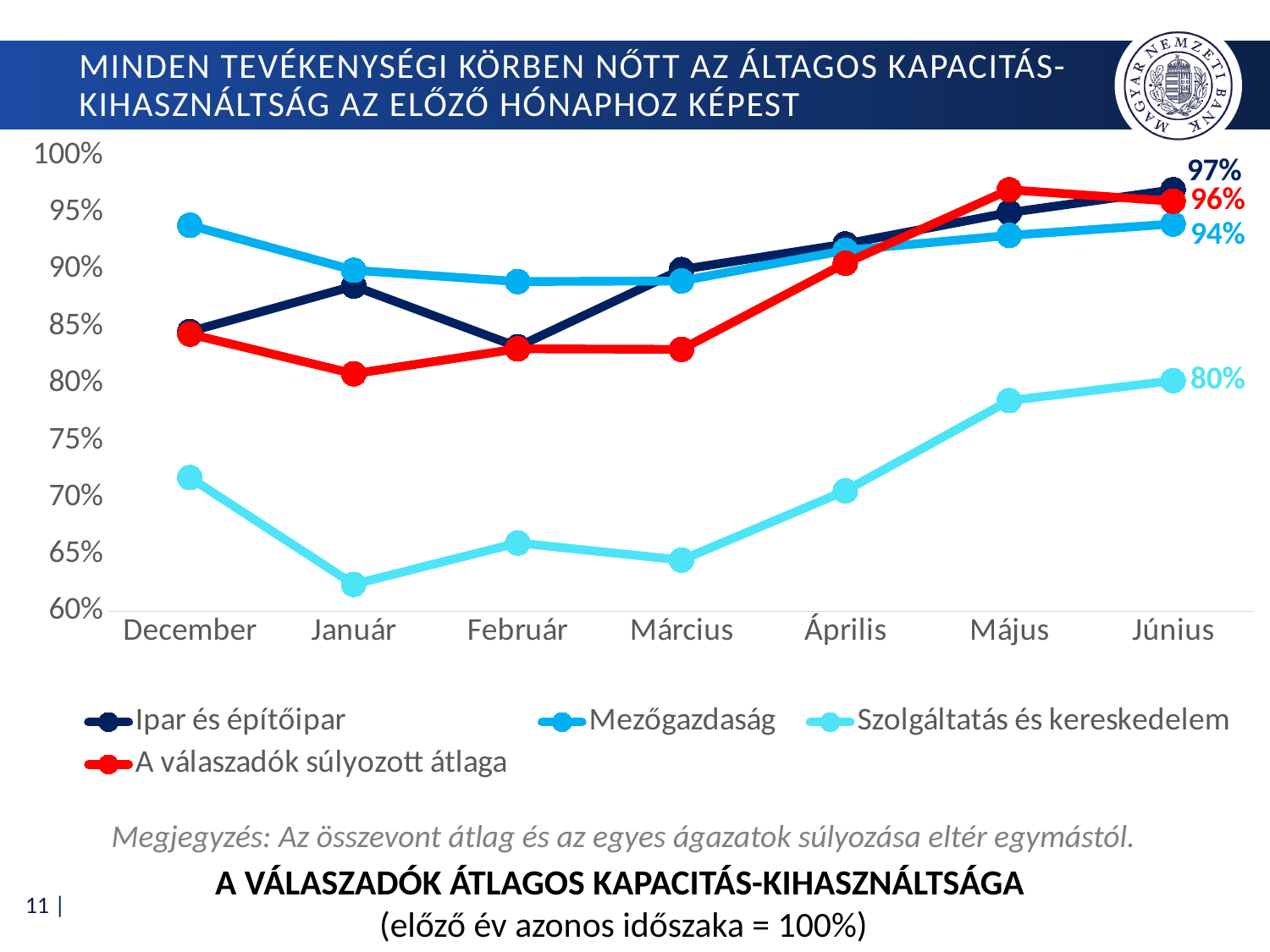
What is the value for Mezőgazdaság in Június? 94% What is the value for Szolgáltatás és kereskedelem in Június? 80% How many months are shown on the x axis? 7 Is the value for Szolgáltatás és kereskedelem in Január greater or less than 65%? less In December, which is higher: Mezőgazdaság or Ipar és építőipar? Mezőgazdaság How many series does the legend list? 4 Which series has the lowest value in Június? Szolgáltatás és kereskedelem Which series has the highest value in Június? Ipar és építőipar What is the value for Ipar és építőipar in Június? 97% What is the difference between the Június values of Ipar és építőipar and Szolgáltatás és kereskedelem? 17 percentage points Is the value for Mezőgazdaság in December greater or less than 90%? greater What is the value for A válaszadók súlyozott átlaga in Június? 96%